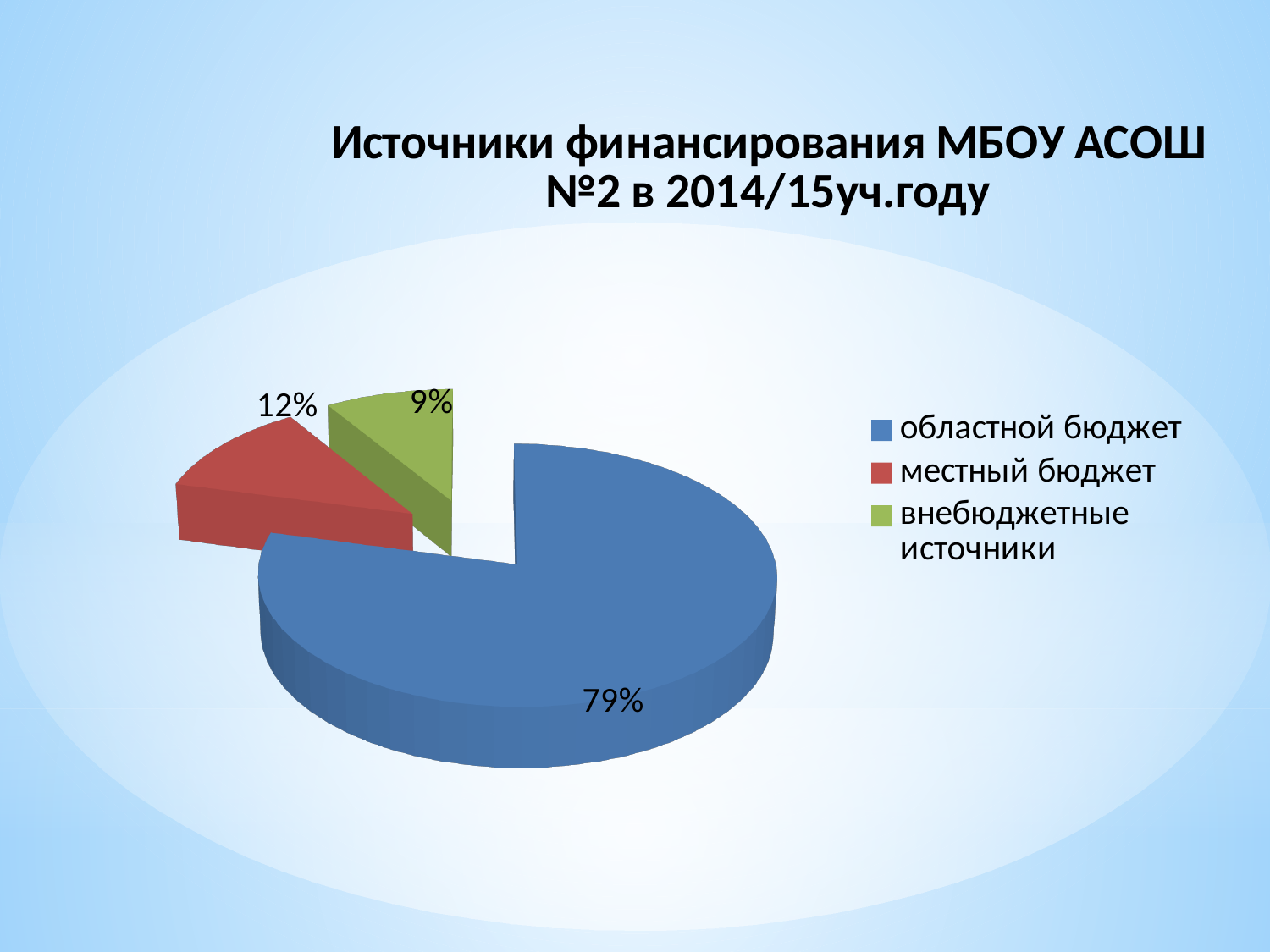
What is the difference in percentage points between областной бюджет and местный бюджет? 67 What share of funding comes from областной бюджет? 79% What colour is the slice for местный бюджет? red What share of funding comes from внебюджетные источники? 9% Which funding source has the smallest share of the pie? внебюджетные источники How many slices does the pie chart have? 3 How many entries does the legend list? 3 What share of funding comes from местный бюджет? 12% Which funding source has the largest share of the pie? областной бюджет What kind of chart is shown on the slide? pie chart Which is larger, the share for местный бюджет or for внебюджетные источники? местный бюджет What is the difference in percentage points between местный бюджет and внебюджетные источники? 3